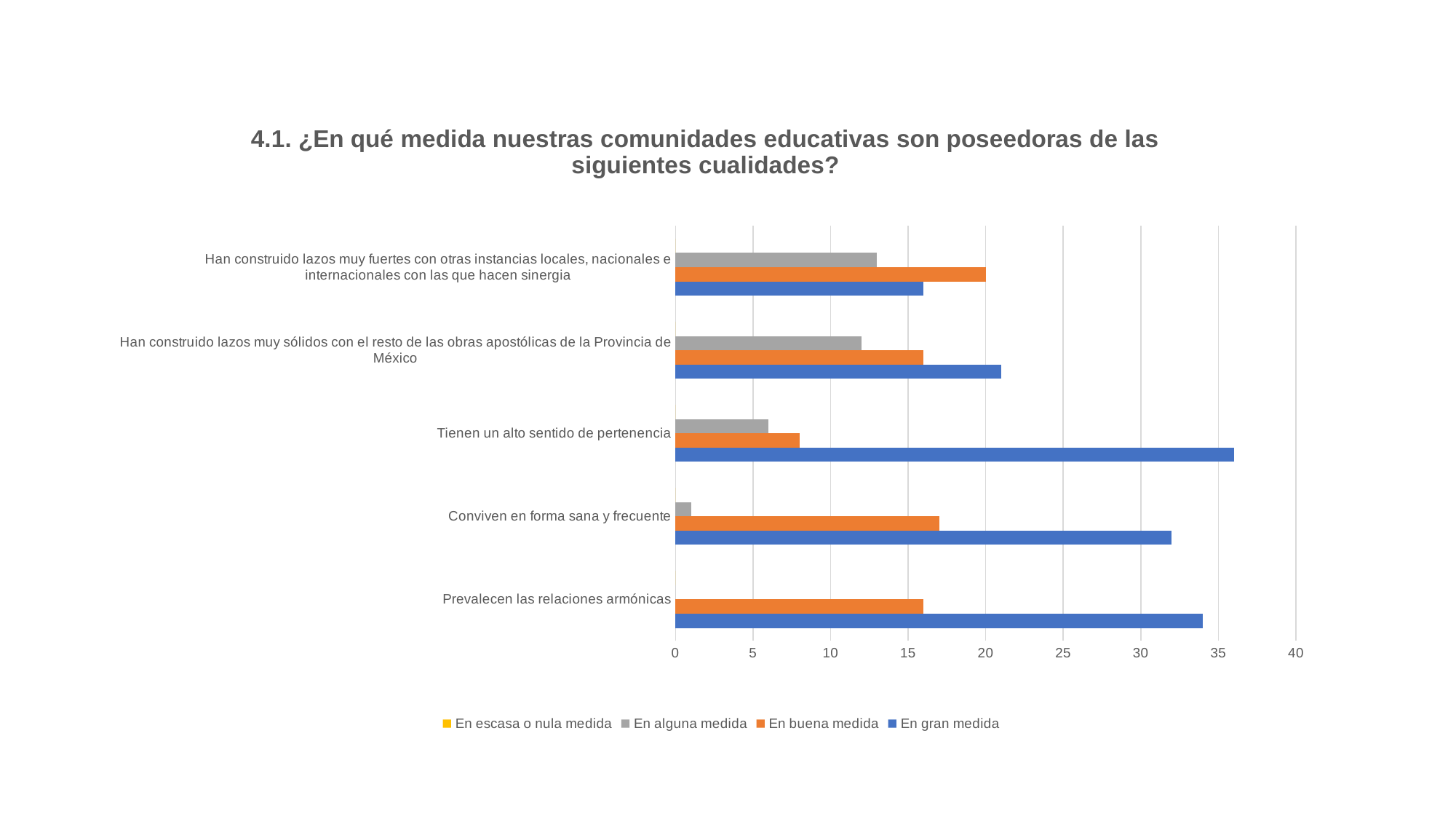
Is the 'En gran medida' value for 'Conviven en forma sana y frecuente' greater or less than 30? greater What kind of chart is shown on the slide? bar chart Is the 'En gran medida' value for 'Prevalecen las relaciones armónicas' greater or less than 35? less Which category has the highest value for 'En gran medida'? Tienen un alto sentido de pertenencia For 'Han construido lazos muy fuertes con otras instancias locales, nacionales e internacionales con las que hacen sinergia', which is larger: 'En buena medida' or 'En gran medida'? En buena medida How many categories are plotted on the chart? 5 Is the 'En gran medida' value for 'Tienen un alto sentido de pertenencia' greater or less than 35? greater How many series does the legend list? 4 Which category has the lowest value for 'En gran medida'? Han construido lazos muy fuertes con otras instancias locales, nacionales e internacionales con las que hacen sinergia What is the value of 'En buena medida' for 'Han construido lazos muy fuertes con otras instancias locales, nacionales e internacionales con las que hacen sinergia'? 20 Which colour represents the 'En gran medida' series in the legend? blue